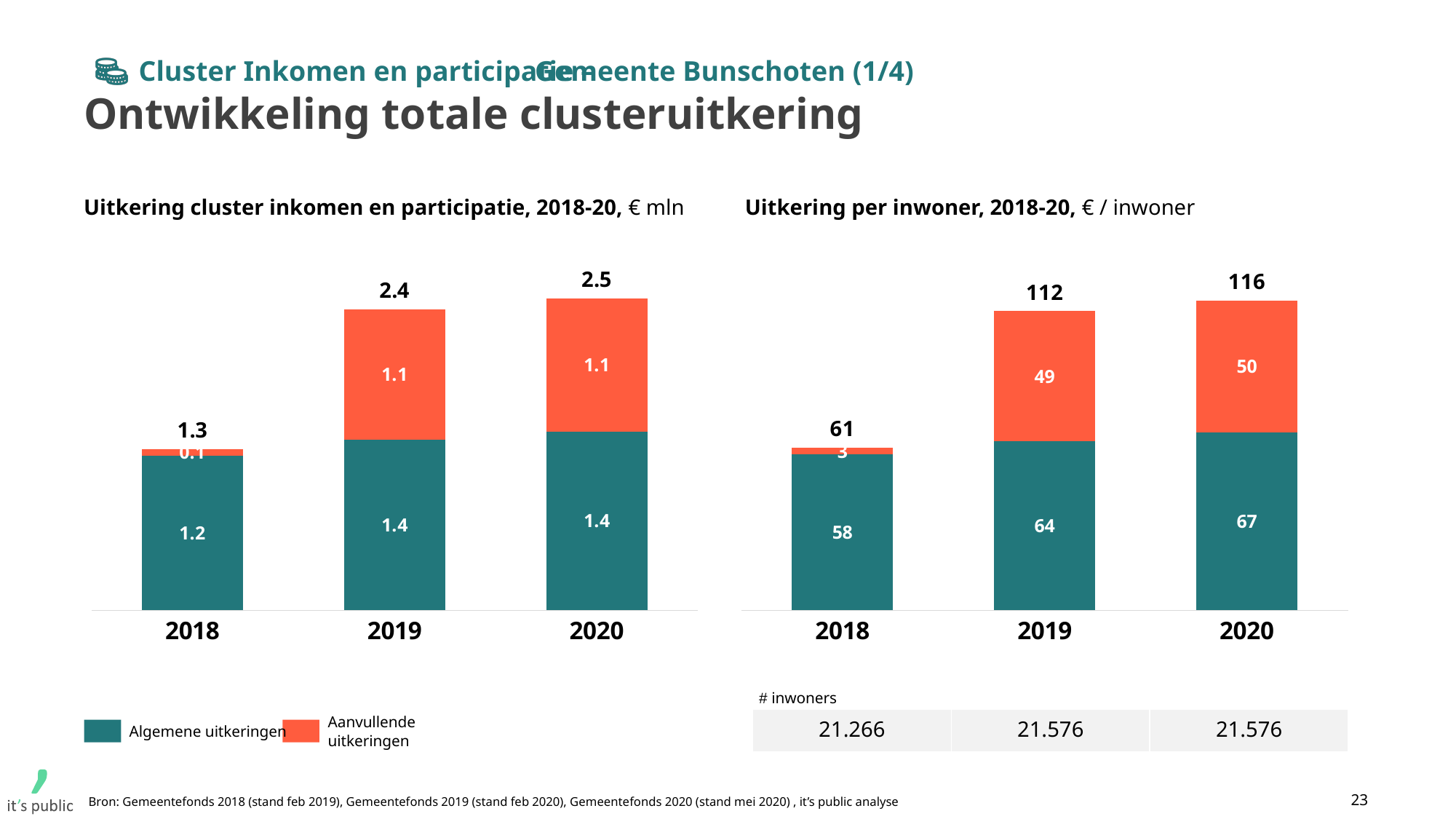
In the chart 'Uitkering per inwoner, 2018-20', which year has the highest total? 2020 In the chart 'Uitkering cluster inkomen en participatie, 2018-20', what is the value of Aanvullende uitkeringen for 2018? 0.1 How many series does the legend list for the charts on this slide? 2 In the chart 'Uitkering per inwoner, 2018-20', what is the value of Algemene uitkeringen for 2020? 67 In the chart 'Uitkering per inwoner, 2018-20', what is the difference between the Algemene uitkeringen values for 2020 and 2018? 9 In the chart 'Uitkering per inwoner, 2018-20', what is the value of Aanvullende uitkeringen for 2019? 49 In the chart 'Uitkering cluster inkomen en participatie, 2018-20', which year has the lowest total? 2018 What kind of chart is 'Uitkering cluster inkomen en participatie, 2018-20'? Stacked bar chart In the chart 'Uitkering cluster inkomen en participatie, 2018-20', what is the total printed above the 2020 bar? 2.5 In the chart 'Uitkering per inwoner, 2018-20', what is the total printed above the 2019 bar? 112 In the chart 'Uitkering cluster inkomen en participatie, 2018-20', what is the value of Algemene uitkeringen for 2019? 1.4 In the chart 'Uitkering per inwoner, 2018-20', is the Aanvullende uitkeringen value larger for 2018 or for 2020? 2020